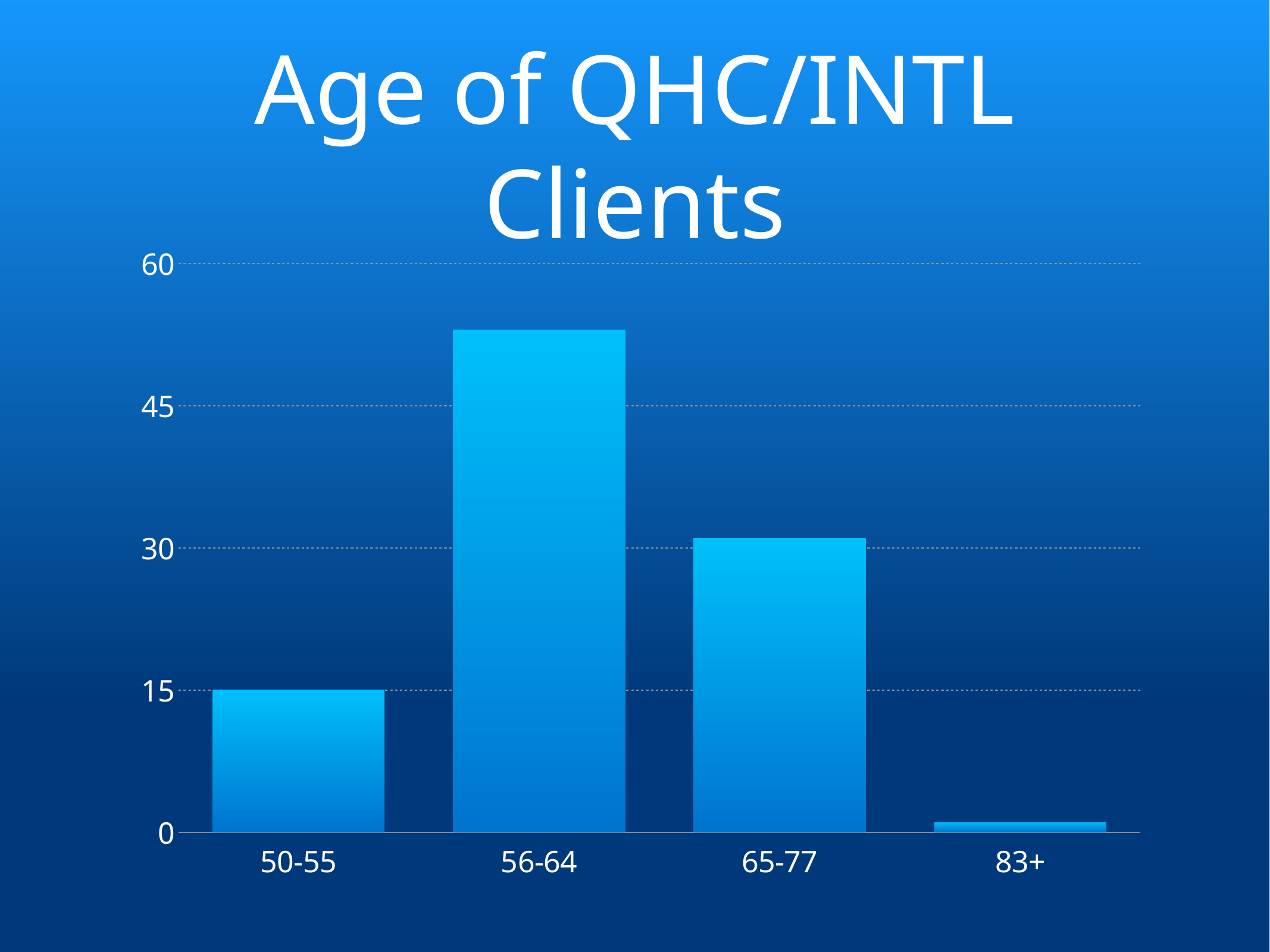
Which age group has the highest value? 56-64 How many age categories are shown on the x axis? 4 Which age group has the lowest value? 83+ Is the value for the 83+ age group greater or less than 15? less What is the value for the 50-55 age group? 15 Which is larger, the value for 65-77 or the value for 50-55? 65-77 Is the value for the 56-64 age group greater or less than 45? greater What type of chart is shown on the slide? bar chart What is the title of the chart? Age of QHC/INTL Clients Which is larger, the value for 56-64 or the value for 65-77? 56-64 Is the value for the 65-77 age group greater or less than 45? less What is the highest value shown on the vertical axis? 60